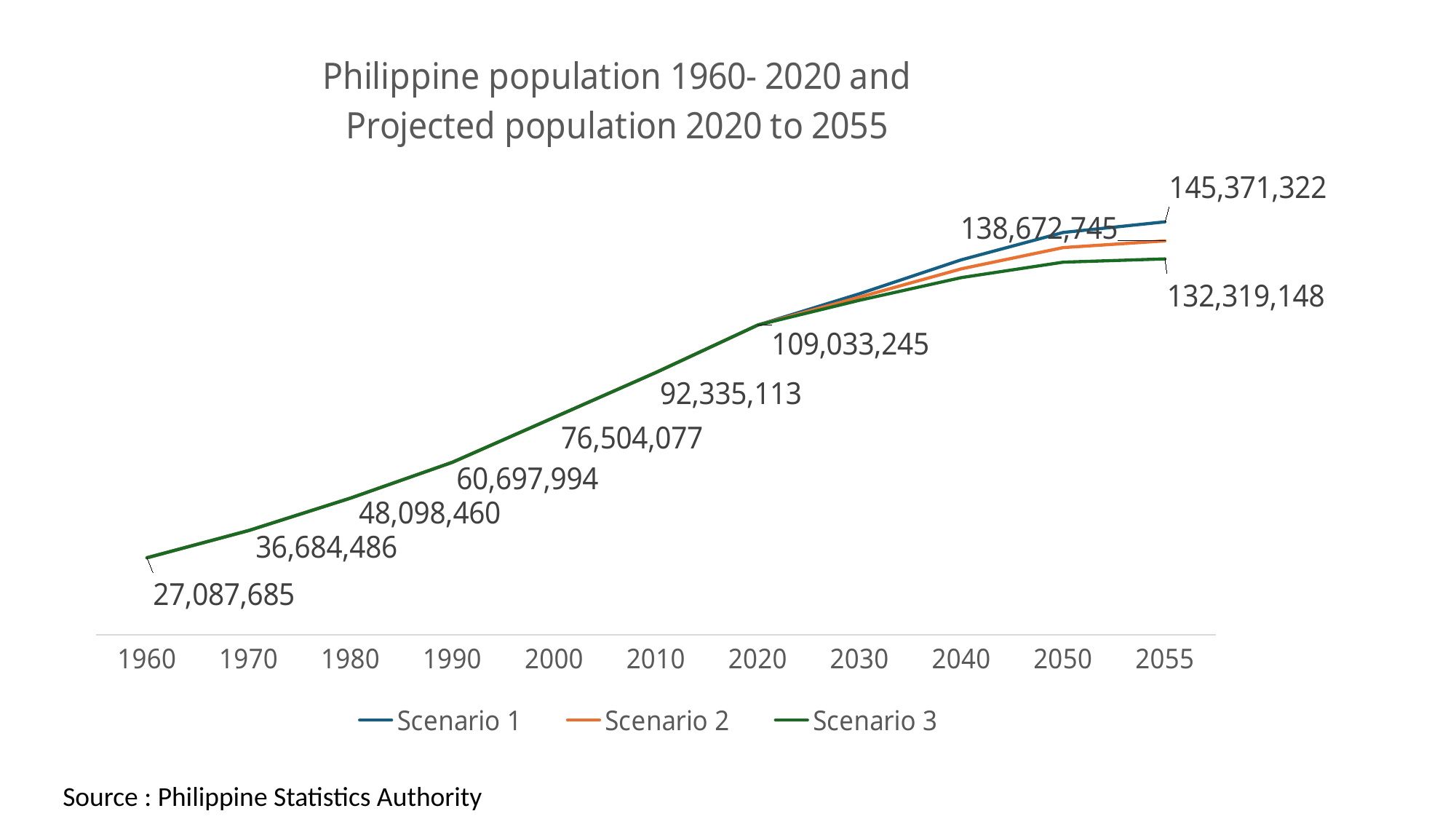
What type of chart is shown on the slide? Line chart What is the projected population in 2055 under Scenario 3? 132,319,148 What was the Philippine population in 2020? 109,033,245 How many years are labelled on the x axis? 11 What was the Philippine population in 1960? 27,087,685 How many series does the legend list? 3 What is the difference between the 2055 projections for Scenario 1 and Scenario 3? 13,052,174 What was the Philippine population in 1990? 60,697,994 Do the population values rise or fall from 1960 to 2020? Rise Which scenario gives the lowest projected population in 2055? Scenario 3 What is the projected population in 2055 under Scenario 1? 145,371,322 Which scenario gives the highest projected population in 2055? Scenario 1